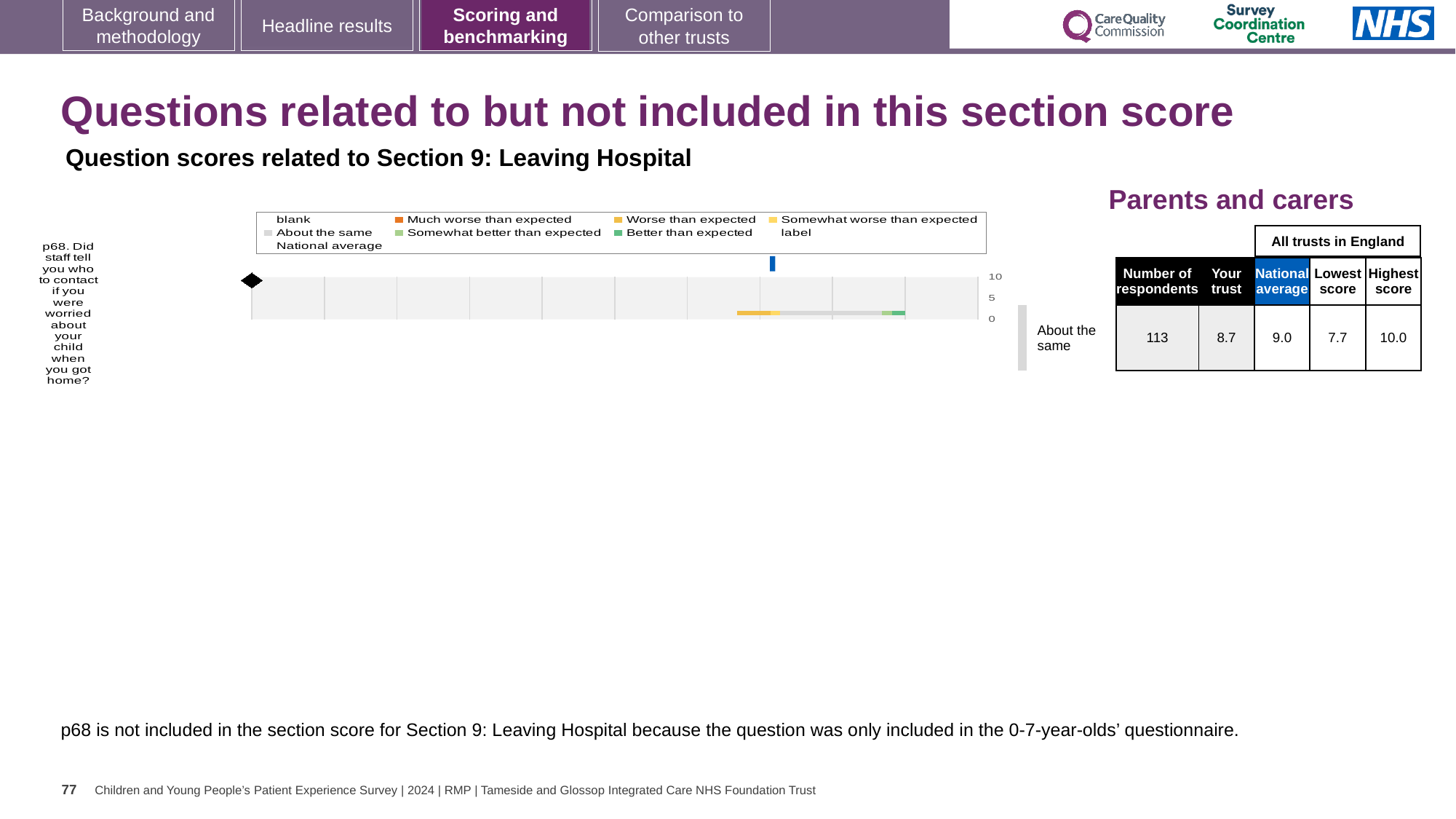
How many questions (categories) are plotted in the chart? 1 What kind of chart is shown for question p68? bar chart What colour does the legend use for 'Much worse than expected'? orange How many respondents answered p68? 113 What is the difference between the highest score and the lowest score for p68 across all trusts in England? 2.3 How many entries does the chart legend list? 9 Which is larger for p68, the trust's score or the national average? national average What is the difference between the national average and the trust's score for p68? 0.3 Which question number is plotted in the chart? p68 What is the national average score for p68? 9.0 What is the 'Your trust' score for p68? 8.7